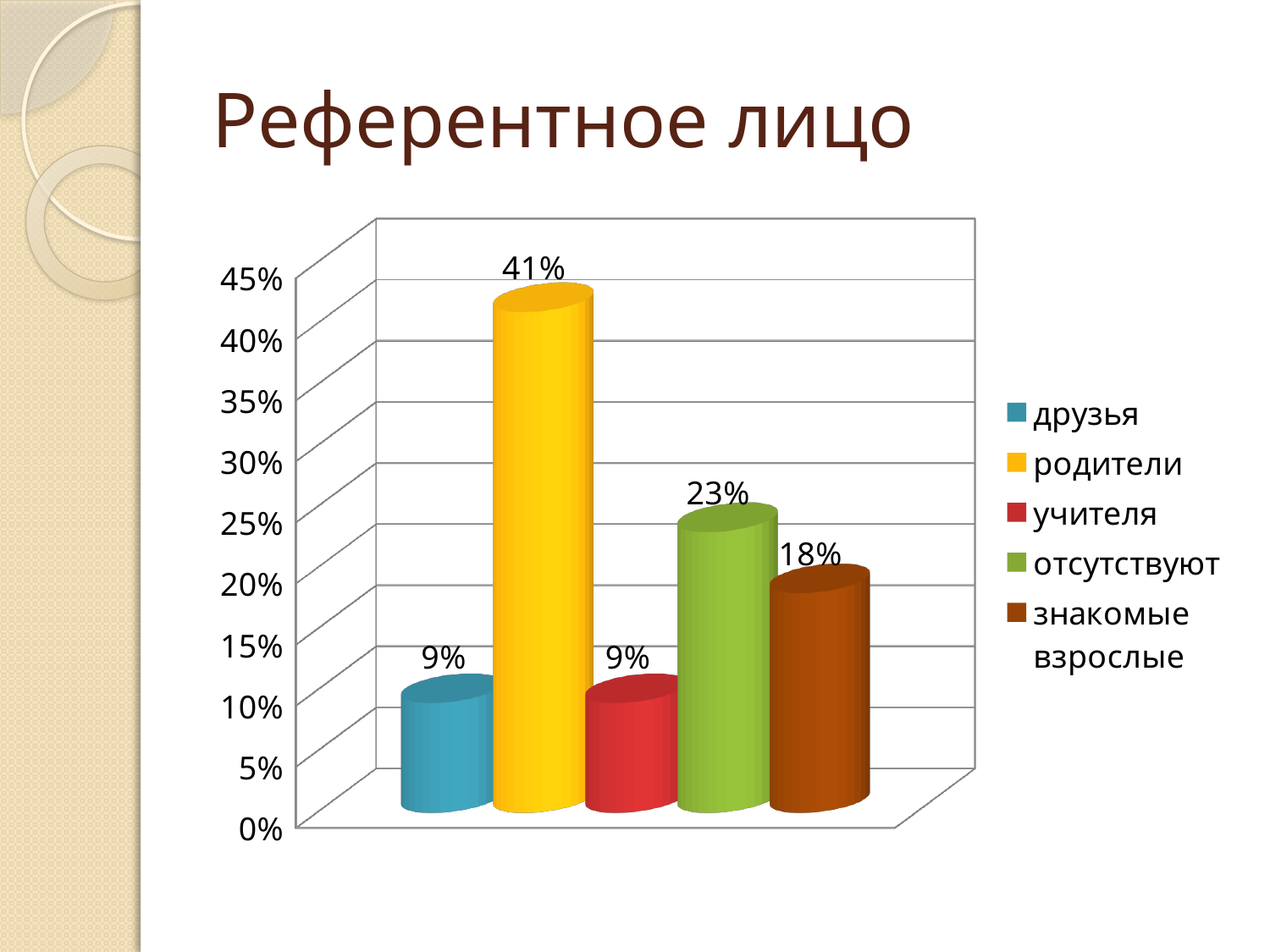
How many categories are plotted in the chart? 5 What is the title of the slide? Референтное лицо What is the value for отсутствуют? 23% Which category has the highest value? родители Which is larger, the value for учителя or the value for знакомые взрослые? знакомые взрослые What is the difference between the values for отсутствуют and знакомые взрослые? 5% What kind of chart is shown on the slide? bar chart What is the value for родители? 41% Is the value for родители greater or less than 40%? greater What is the value for знакомые взрослые? 18% What is the value for друзья? 9% What is the difference between the values for родители and отсутствуют? 18%